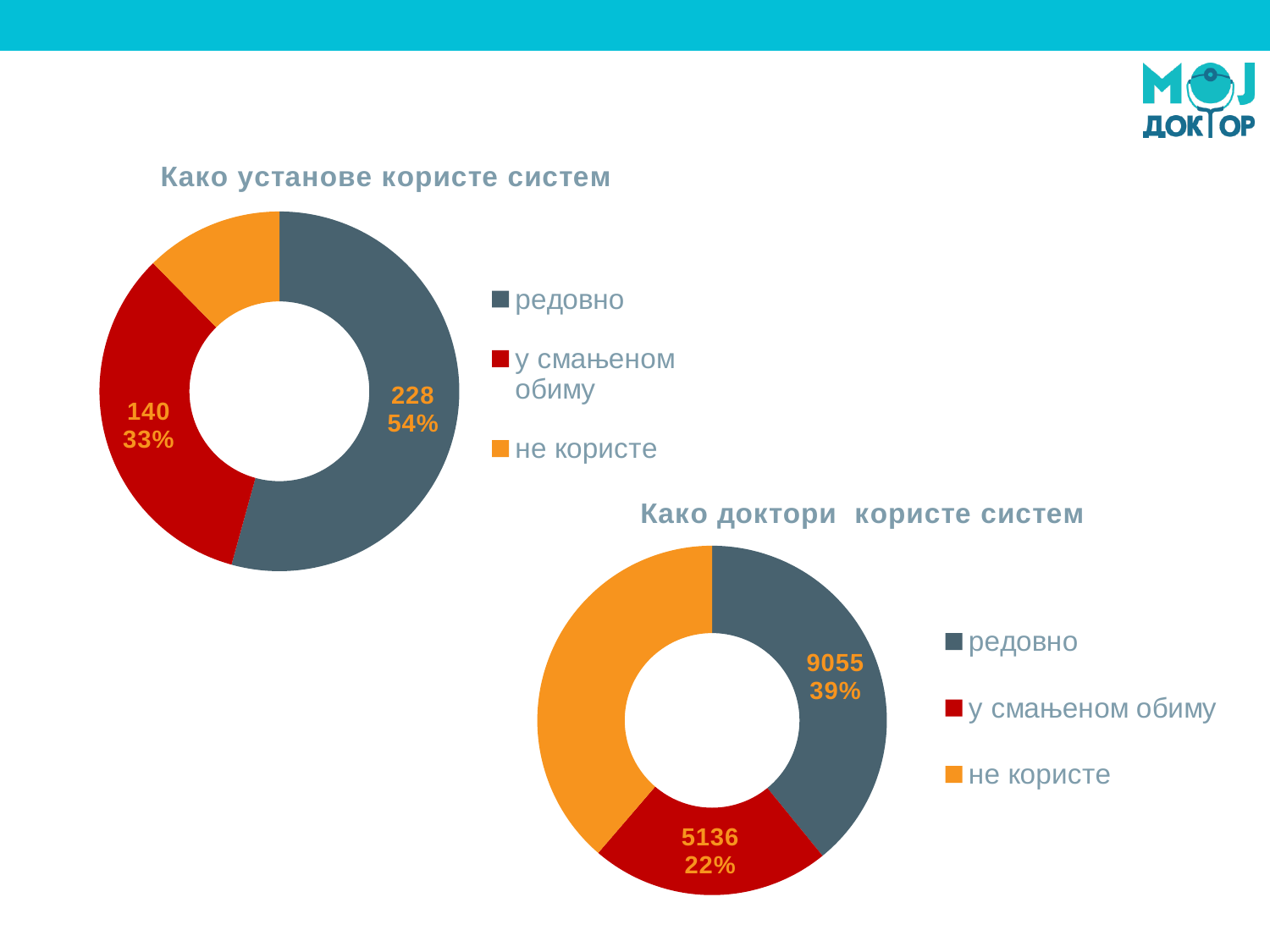
In the chart titled "Како установе користе систем", which category has the smallest slice? не користе In the chart titled "Како доктори користе систем", what value is shown for "у смањеном обиму"? 5136 In the chart titled "Како доктори користе систем", which category has the smallest slice? у смањеном обиму In the chart titled "Како установе користе систем", what value is shown for "редовно"? 228 In the chart titled "Како установе користе систем", which category has the largest slice? редовно In the chart titled "Како доктори користе систем", what share of the total does "редовно" represent? 39% How many categories does the legend of the chart titled "Како установе користе систем" list? 3 What type of chart is the chart titled "Како доктори користе систем"? Doughnut (pie) chart In the chart titled "Како установе користе систем", what is the difference between the values for "редовно" and "у смањеном обиму"? 88 In the chart titled "Како установе користе систем", what percentage is shown for "у смањеном обиму"? 33% In the chart titled "Како доктори користе систем", what value is shown for "редовно"? 9055 In the chart titled "Како доктори користе систем", what is the difference between the values for "редовно" and "у смањеном обиму"? 3919